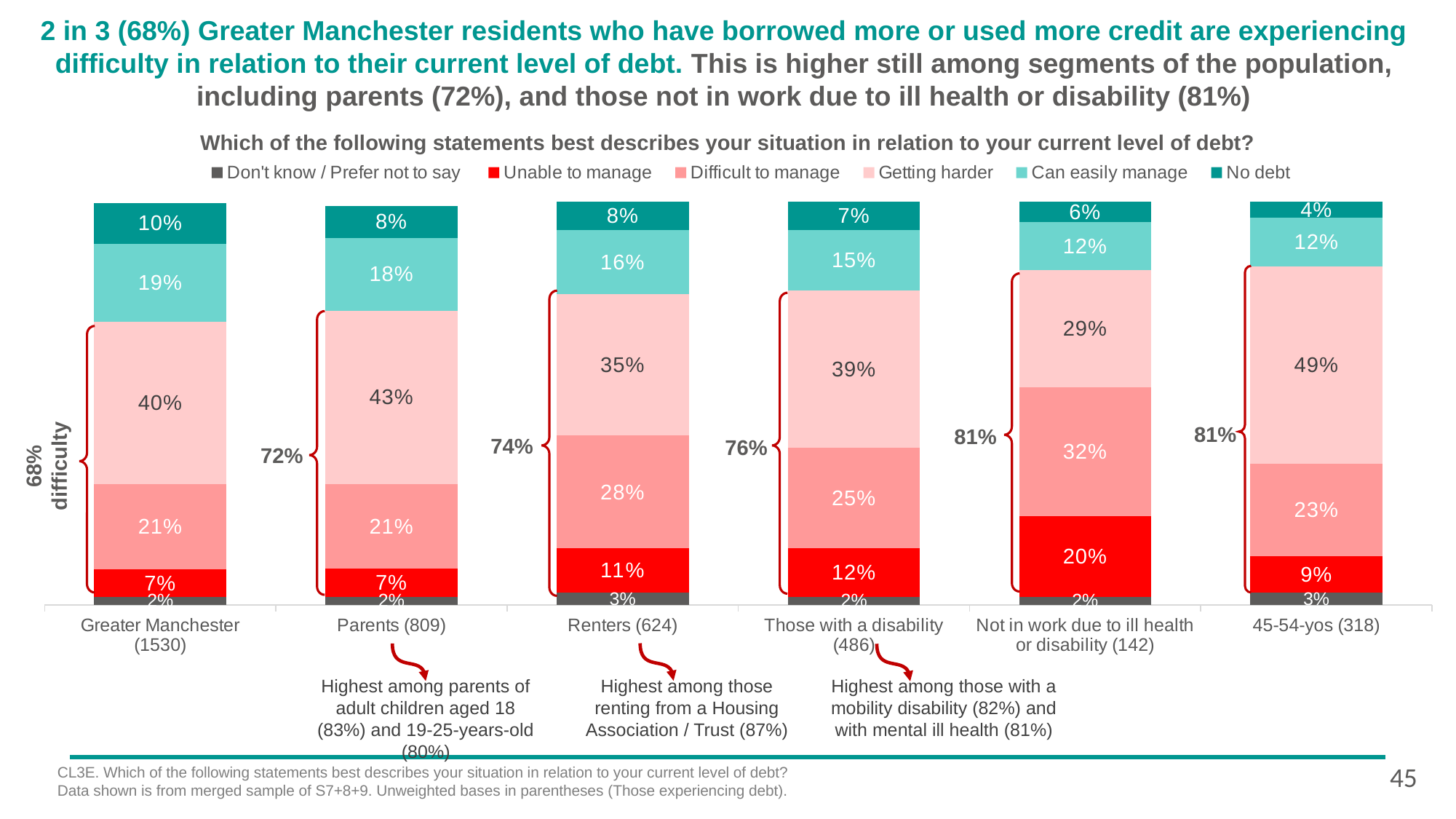
Which legend entry is shown in dark grey? Don't know / Prefer not to say What is the difference between the 'Difficult to manage' values for Renters (624) and Parents (809)? 7% How many categories are shown on the x axis? 6 What combined 'difficulty' percentage is shown by the bracket for Those with a disability (486)? 76% What is the 'Unable to manage' value for Not in work due to ill health or disability (142)? 20% What is the 'No debt' value for 45-54-yos (318)? 4% Which category has the highest 'Getting harder' value? 45-54-yos (318) What kind of chart is shown on the slide? Stacked bar chart Which category has the lowest 'No debt' value? 45-54-yos (318) How many series does the legend list? 6 Which is larger: the 'Can easily manage' value for Greater Manchester (1530) or for Renters (624)? Greater Manchester (1530) What percentage of Greater Manchester (1530) respondents said their debt is 'Getting harder'? 40%